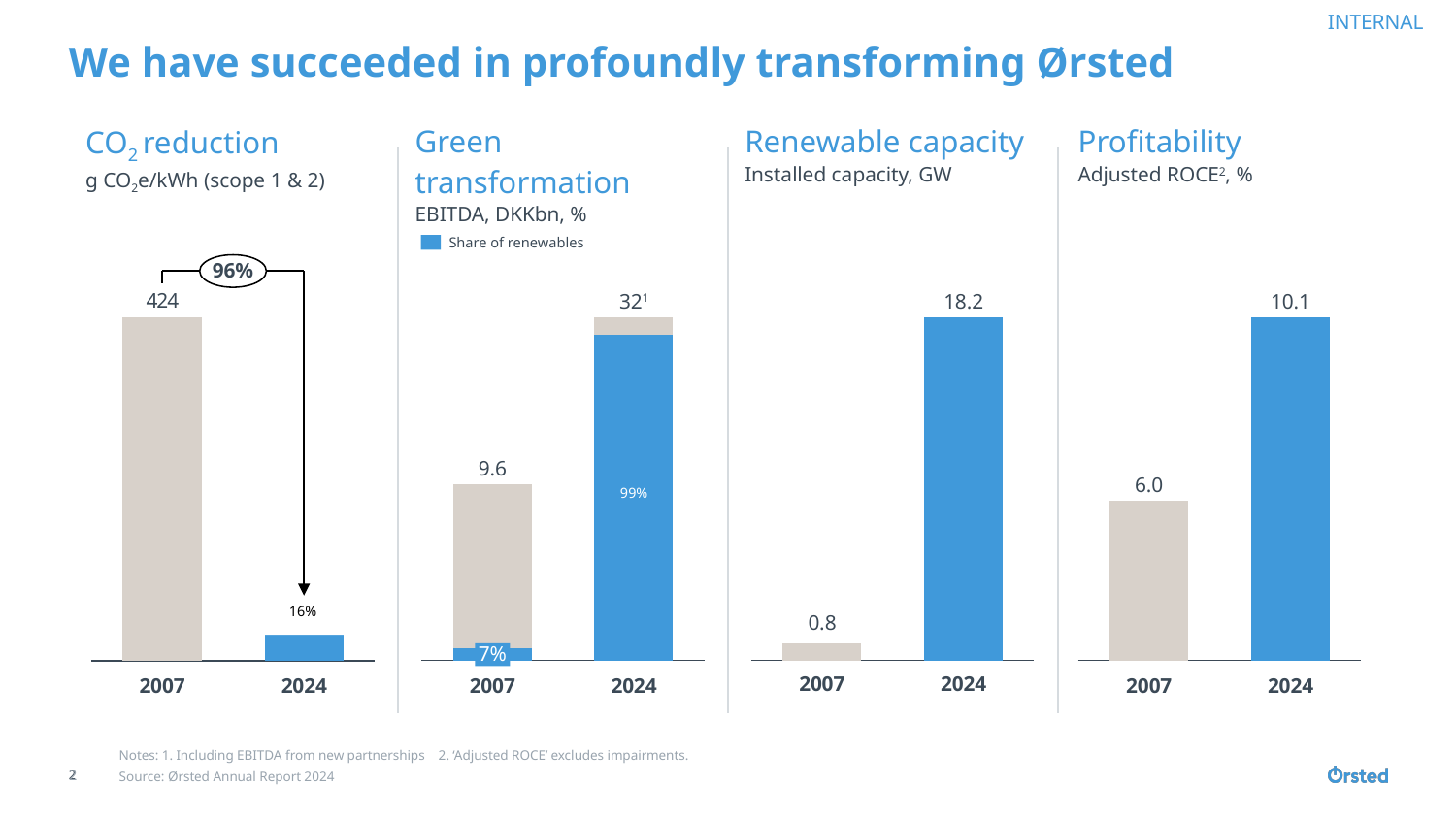
In the Renewable capacity chart, what is the difference in installed capacity between 2024 and 2007? 17.4 In the Profitability chart, which year has the higher adjusted ROCE, 2007 or 2024? 2024 In the Profitability chart, what is the adjusted ROCE for 2007? 6.0 In the Green transformation chart, what is the EBITDA value for 2007? 9.6 In the CO2 reduction chart, what percentage reduction is shown between 2007 and 2024? 96% In the Green transformation chart, what is the share of renewables in 2007? 7% In the Profitability chart, what is the difference in adjusted ROCE between 2024 and 2007? 4.1 What kind of chart is the Renewable capacity chart? Bar chart In the Green transformation chart, what is the share of renewables in 2024? 99% In the Green transformation chart, what is the EBITDA value for 2024? 32 In the CO2 reduction chart, what is the value for 2007? 424 In the Renewable capacity chart, what is the installed capacity for 2024? 18.2